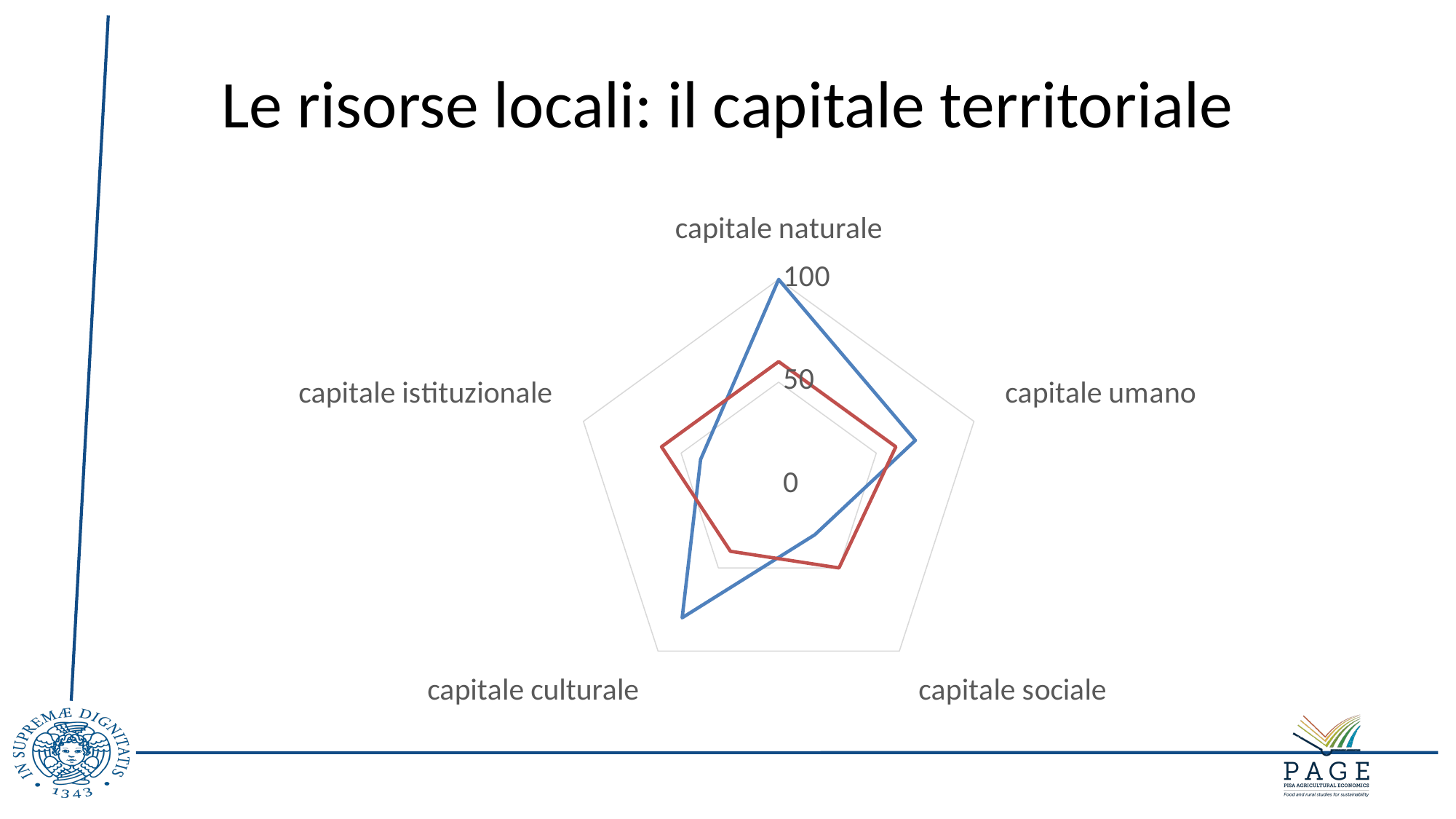
How many categories (axes) does the radar chart have? 5 Is the red series value for capitale istituzionale greater or less than 50? greater What kind of chart is shown on the slide? radar chart For capitale naturale, which series has the larger value, the blue or the red? blue What is the highest value shown on the radar chart's axis scale? 100 For capitale istituzionale, which series has the larger value, the blue or the red? red Is the blue series value for capitale sociale greater or less than 50? less What is the title of the slide containing the radar chart? Le risorse locali: il capitale territoriale Is the blue series value for capitale umano greater or less than 50? greater How many data series are plotted on the radar chart? 2 What value does the blue series reach for capitale naturale? 100